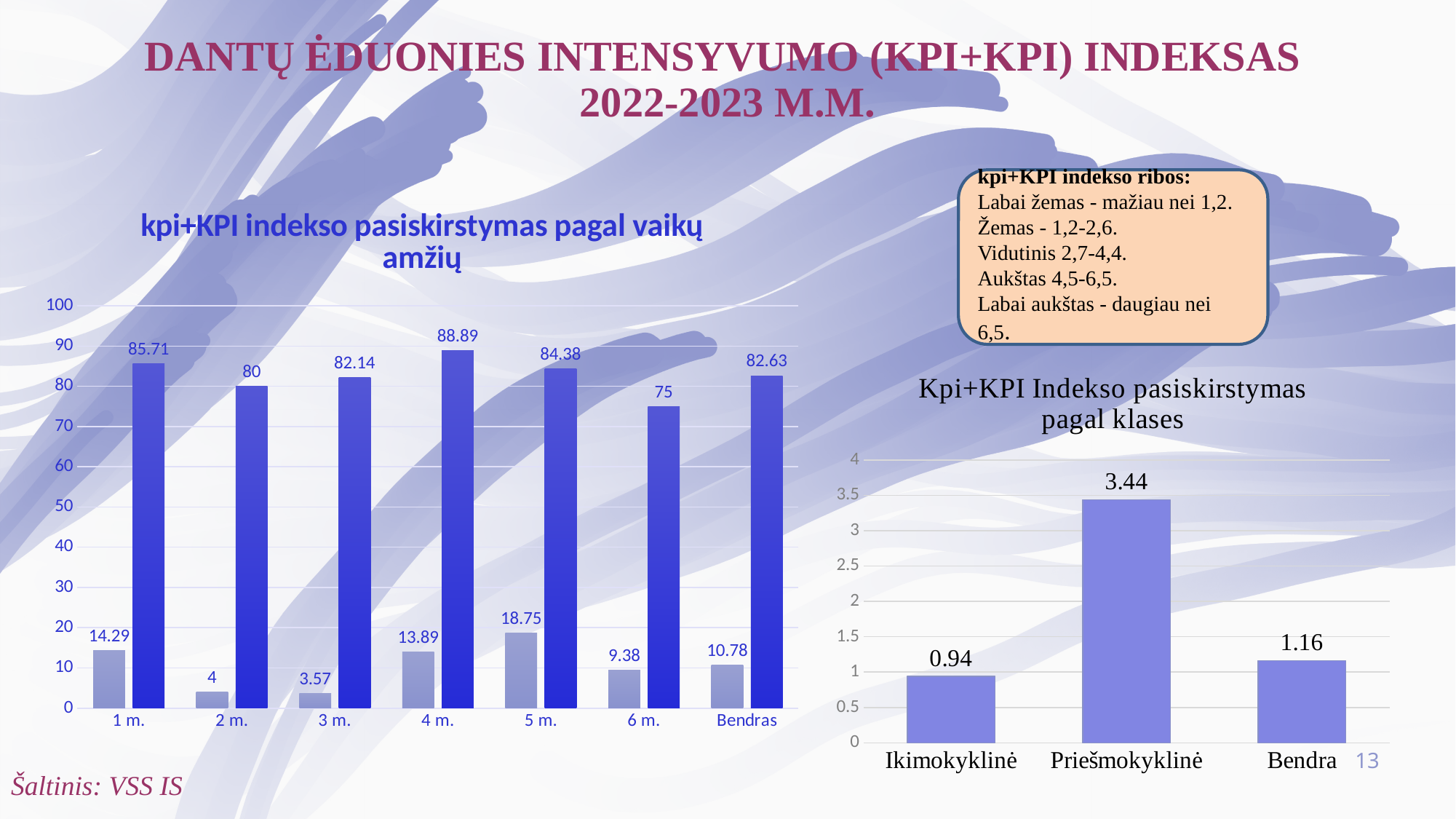
In the chart 'Kpi+KPI Indekso pasiskirstymas pagal klases', how many categories are shown? 3 What kind of chart is 'kpi+KPI indekso pasiskirstymas pagal vaikų amžių'? Bar chart In the chart 'Kpi+KPI Indekso pasiskirstymas pagal klases', which category has the highest value? Priešmokyklinė In the chart 'kpi+KPI indekso pasiskirstymas pagal vaikų amžių', which category has the lowest value among the shorter grey bars? 3 m. In the chart 'Kpi+KPI Indekso pasiskirstymas pagal klases', what is the difference between the values for Priešmokyklinė and Bendra? 2.28 In the chart 'Kpi+KPI Indekso pasiskirstymas pagal klases', what is the value for Ikimokyklinė? 0.94 In the chart 'kpi+KPI indekso pasiskirstymas pagal vaikų amžių', is the taller blue bar for 1 m. or for 6 m. larger? 1 m. In the chart 'kpi+KPI indekso pasiskirstymas pagal vaikų amžių', what is the value of the taller blue bar for 4 m.? 88.89 In the chart 'kpi+KPI indekso pasiskirstymas pagal vaikų amžių', which category has the highest value among the taller blue bars? 4 m. In the chart 'Kpi+KPI Indekso pasiskirstymas pagal klases', which category has the lowest value? Ikimokyklinė In the chart 'Kpi+KPI Indekso pasiskirstymas pagal klases', what is the value for Priešmokyklinė? 3.44 In the chart 'kpi+KPI indekso pasiskirstymas pagal vaikų amžių', what is the value of the shorter grey bar for 5 m.? 18.75